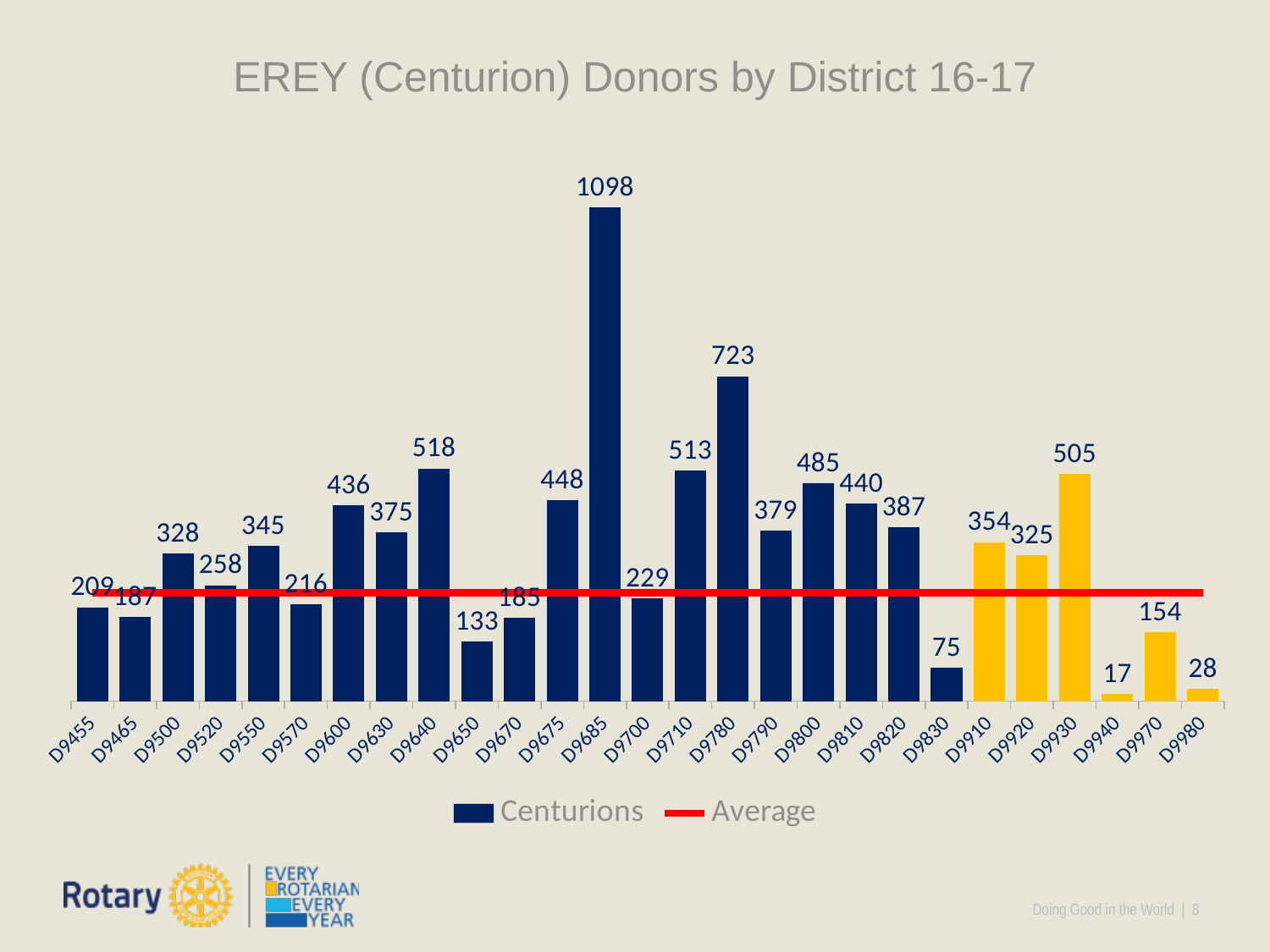
Which is larger, the value for D9800 or the value for D9790? D9800 What is the difference between the values for D9640 and D9630? 143 What kind of chart is shown on the slide? Bar chart What is the value for D9650? 133 How many districts are shown on the x axis? 27 What is the value for D9930? 505 What is the difference between the values for D9685 and D9780? 375 Which district has the lowest number of Centurions? D9940 How many entries does the legend list? 2 What is the title of the chart? EREY (Centurion) Donors by District 16-17 What is the value for D9685? 1098 Which district has the highest number of Centurions? D9685